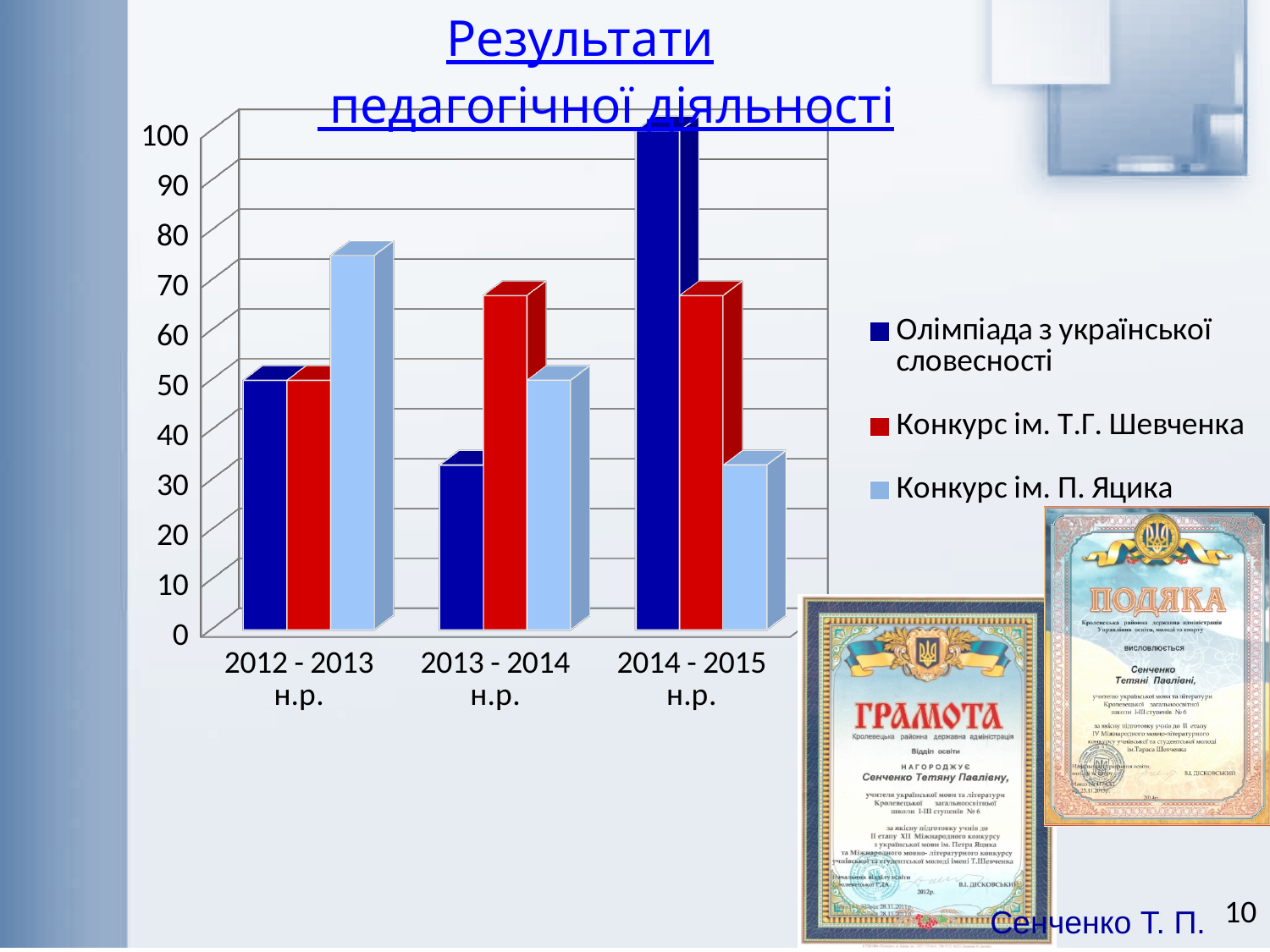
Which school year has the highest value for Конкурс ім. П. Яцика? 2012 - 2013 н.р. What kind of chart is shown on the slide? bar chart Is the value for Олімпіада з української словесності in 2014 - 2015 н.р. greater or less than 90? greater In 2013 - 2014 н.р., which is larger: Конкурс ім. Т.Г. Шевченка or Олімпіада з української словесності? Конкурс ім. Т.Г. Шевченка Is the value for Конкурс ім. П. Яцика in 2012 - 2013 н.р. greater or less than 70? greater Does the value for Конкурс ім. П. Яцика rise or fall across the school years from 2012 - 2013 to 2014 - 2015? fall How many series does the legend list? 3 Is the value for Олімпіада з української словесності in 2013 - 2014 н.р. greater or less than 40? less Which school year has the highest value for Олімпіада з української словесності? 2014 - 2015 н.р. Which colour represents Конкурс ім. Т.Г. Шевченка in the legend? red How many school-year categories are shown on the x axis? 3 Which school year has the lowest value for Конкурс ім. П. Яцика? 2014 - 2015 н.р.